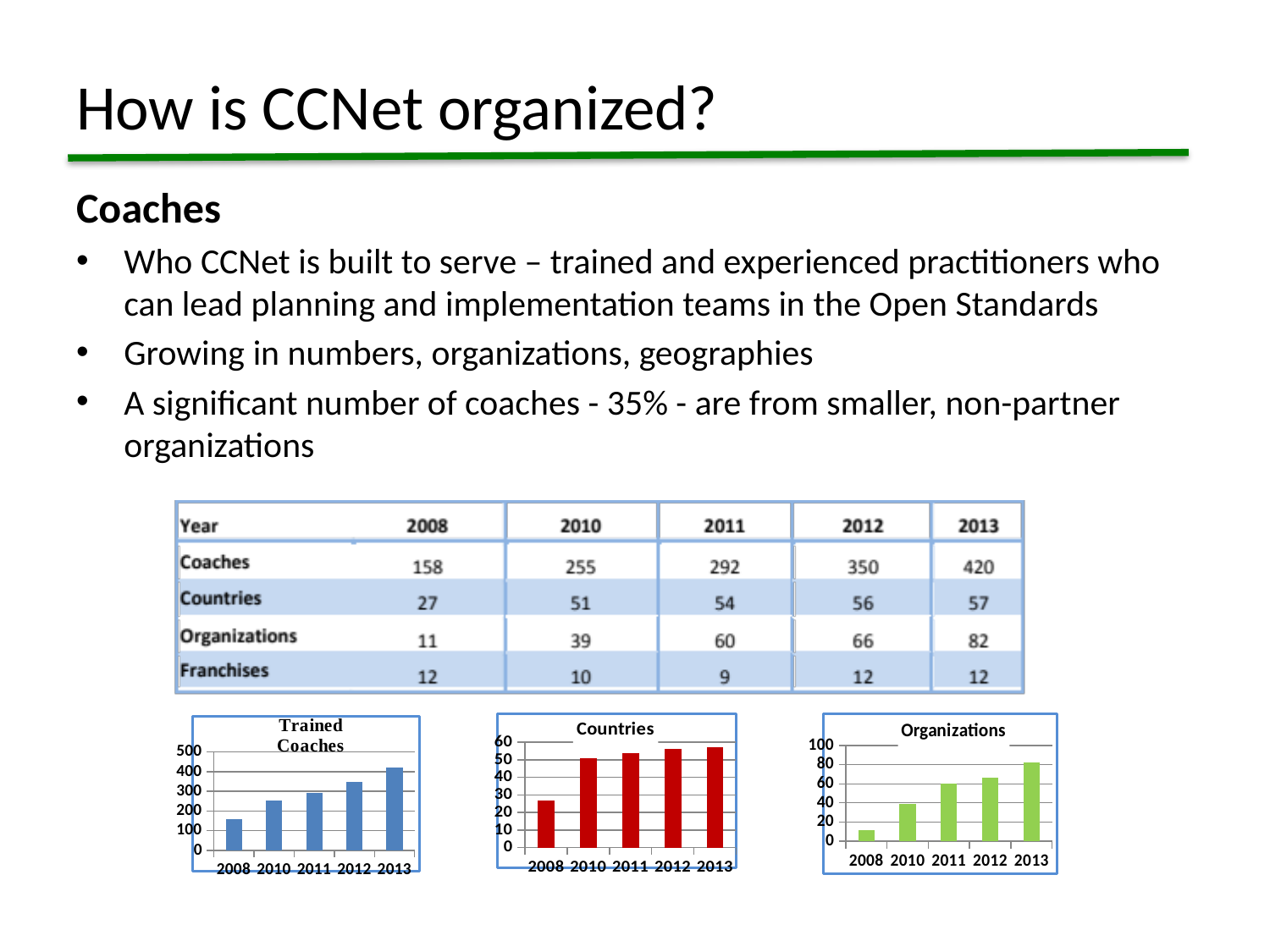
In the "Trained Coaches" chart, is the value for 2012 greater or less than 300? greater In the "Trained Coaches" chart, which year has the lowest value? 2008 What kind of chart is the "Trained Coaches" chart? bar chart In the "Countries" chart, is the value for 2008 greater or less than 30? less In the "Organizations" chart, which year has the lowest value? 2008 In the "Trained Coaches" chart, which year has the highest value? 2013 In the "Organizations" chart, do the values rise or fall from 2008 to 2013? rise In the "Trained Coaches" chart, is the value for 2008 greater or less than 200? less In the "Countries" chart, which is larger, the value for 2008 or the value for 2010? 2010 What colour are the bars in the "Countries" chart? red How many years are shown on the x axis of the "Countries" chart? 5